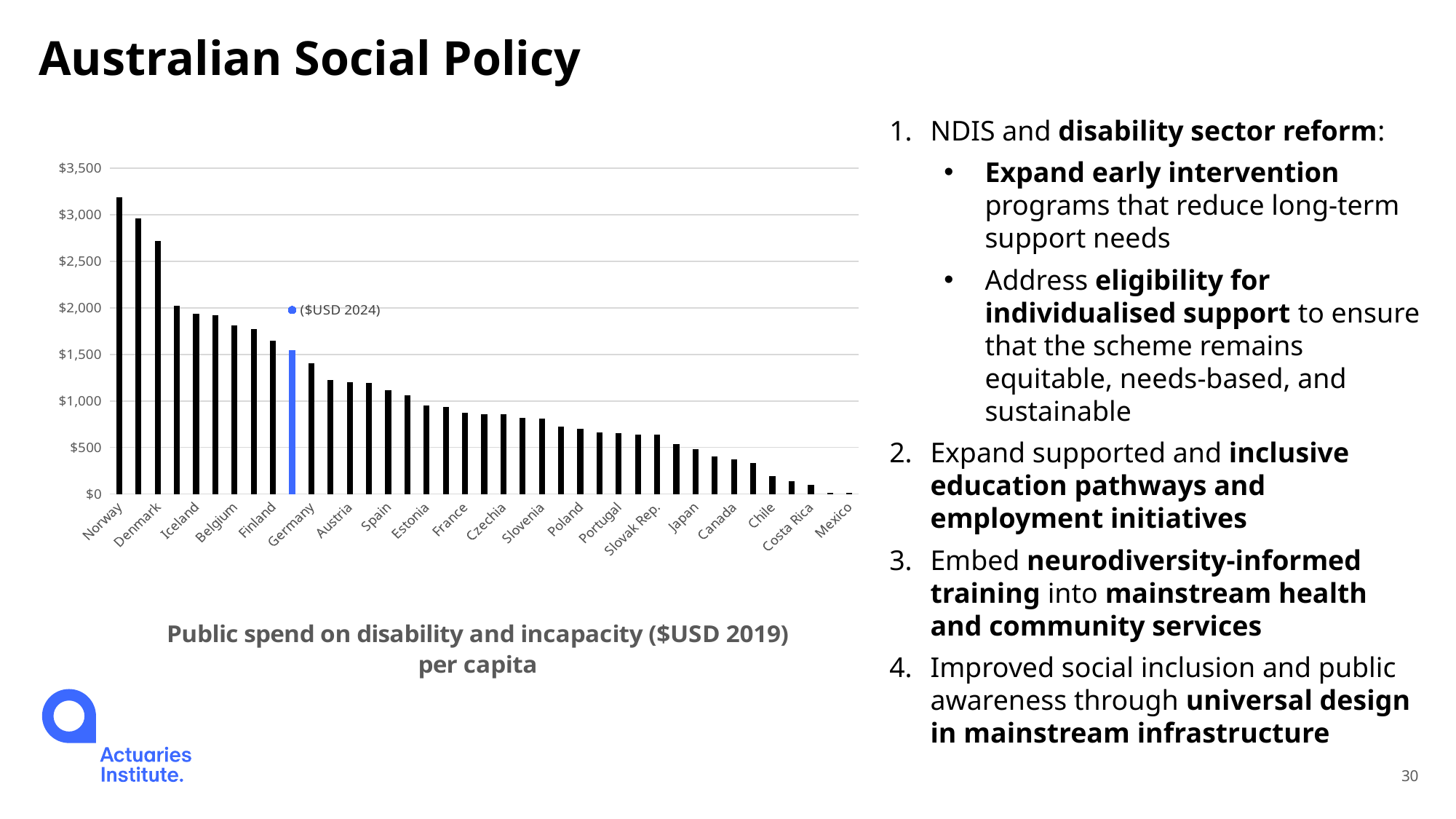
Is the value for Iceland greater or less than $2,500? less What type of chart is shown on the slide? bar chart Which labelled country has the lowest public spend on disability and incapacity per capita? Mexico What is the title of the chart? Public spend on disability and incapacity ($USD 2019) per capita Is the value for Spain greater or less than $1,000? greater Is the value for Norway greater or less than $3,000? greater What text appears next to the blue marker annotation inside the chart? ($USD 2024) Do the bar values rise or fall moving from left to right along the x axis? fall Which country has the highest public spend on disability and incapacity per capita? Norway Which has a higher value, Norway or Denmark? Norway